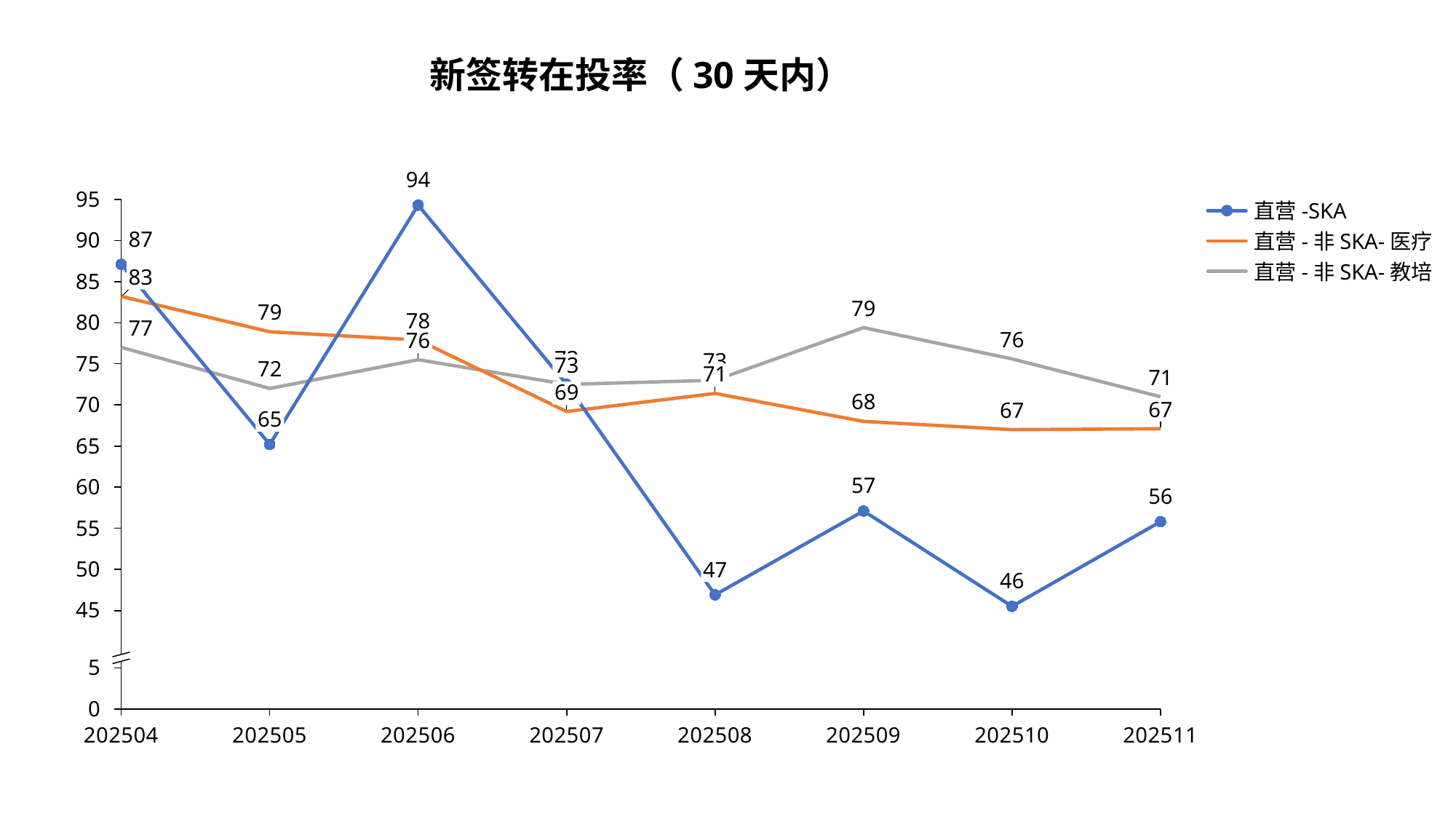
In 202509, which is larger: 直营-非SKA-教培 or 直营-非SKA-医疗? 直营-非SKA-教培 What is the difference between the 直营-SKA values in 202506 and 202505? 29 In which month is the 直营-SKA series lowest? 202510 What is the value for 直营-SKA in 202506? 94 What is the value for 直营-非SKA-医疗 in 202504? 83 How many series does the legend list? 3 Does the 直营-非SKA-医疗 series generally rise or fall from 202504 to 202511? fall What is the title of the chart? 新签转在投率（30天内） What kind of chart is shown on the slide? line chart What is the value for 直营-非SKA-教培 in 202511? 71 In which month is the 直营-SKA series highest? 202506 How many months are plotted along the x axis? 8